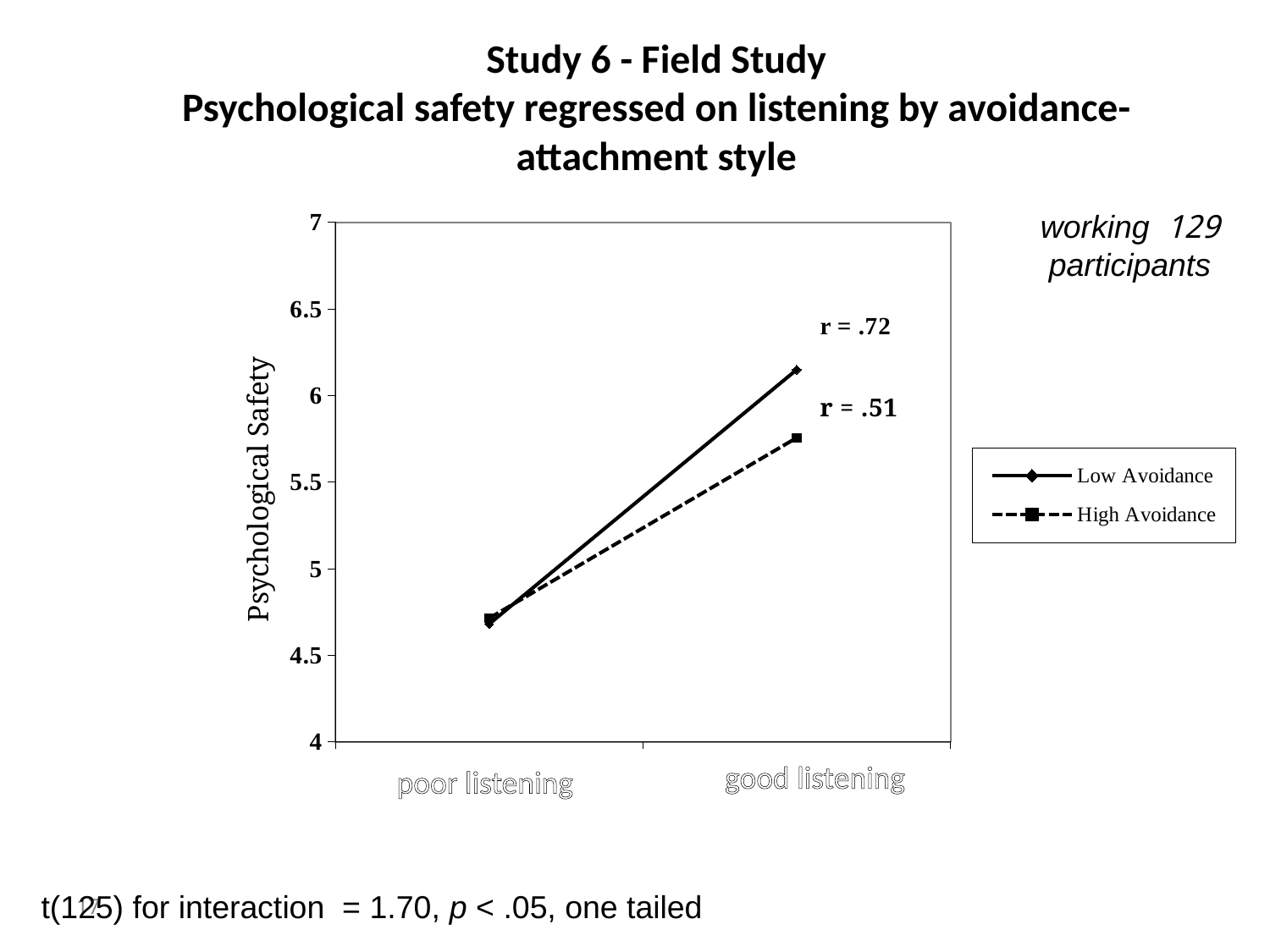
Is the High Avoidance value at good listening greater or less than 6? less Is the Low Avoidance value at good listening greater or less than 6? greater Does psychological safety rise or fall from poor listening to good listening for the Low Avoidance series? rise What kind of chart is shown on the slide? line chart At good listening, which series has the higher psychological safety, Low Avoidance or High Avoidance? Low Avoidance Does psychological safety rise or fall from poor listening to good listening for the High Avoidance series? rise Is the Low Avoidance value at poor listening greater or less than 5? less What is the label of the y axis? Psychological Safety Which series is drawn with a dashed line? High Avoidance How many series does the legend list? 2 How many categories are shown on the x axis? 2